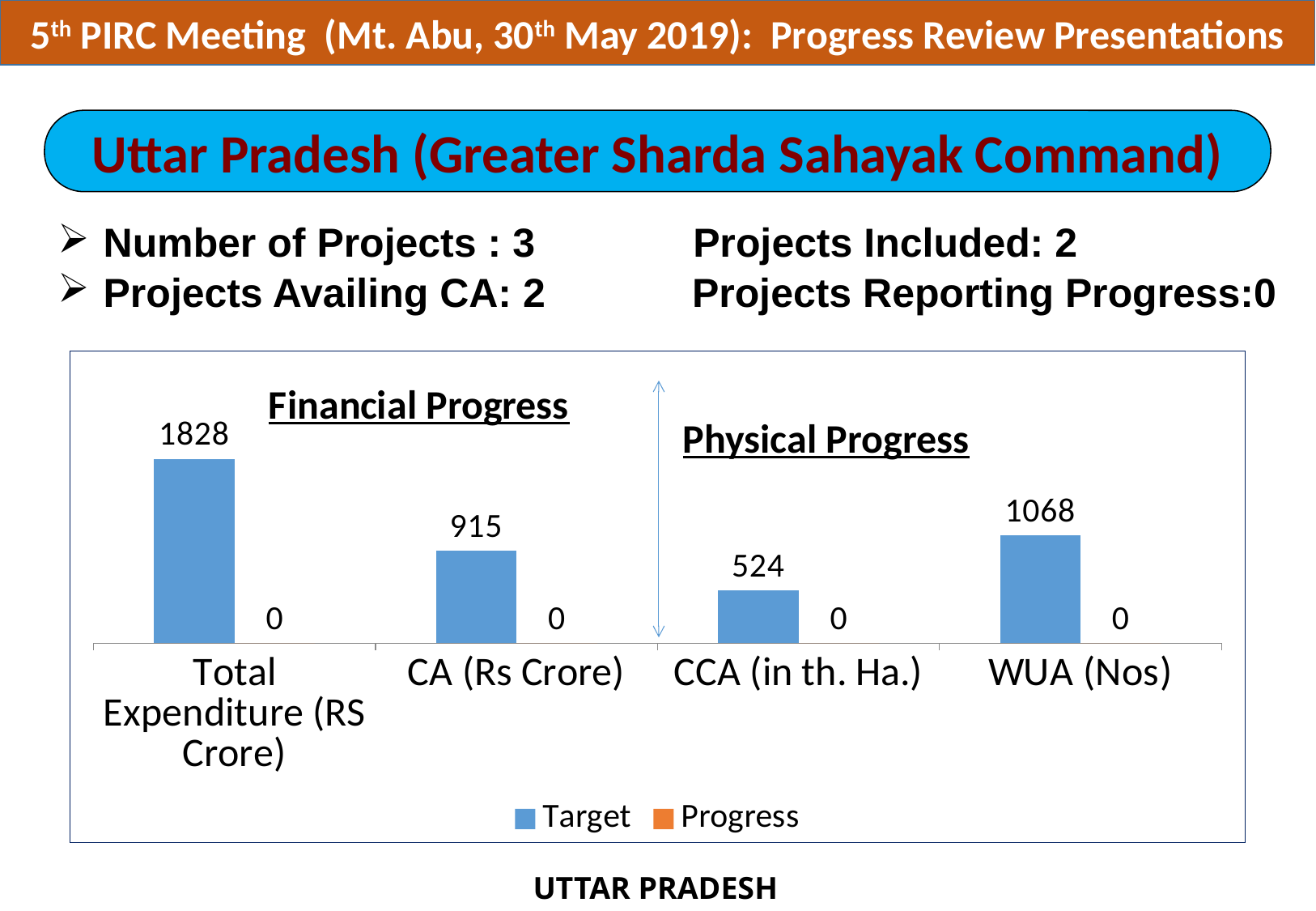
How many categories are shown on the x axis? 4 What is the Target value for WUA (Nos)? 1068 What is the difference between the Target values for Total Expenditure (RS Crore) and CA (Rs Crore)? 913 Which category has the highest Target value? Total Expenditure (RS Crore) How many series does the legend list? 2 What is the Target value for CA (Rs Crore)? 915 Which has a larger Target value, WUA (Nos) or CCA (in th. Ha.)? WUA (Nos) What is the Target value for CCA (in th. Ha.)? 524 What is the Target value for Total Expenditure (RS Crore)? 1828 Which category has the lowest Target value? CCA (in th. Ha.) What kind of chart is shown? Bar chart What is the Progress value for WUA (Nos)? 0